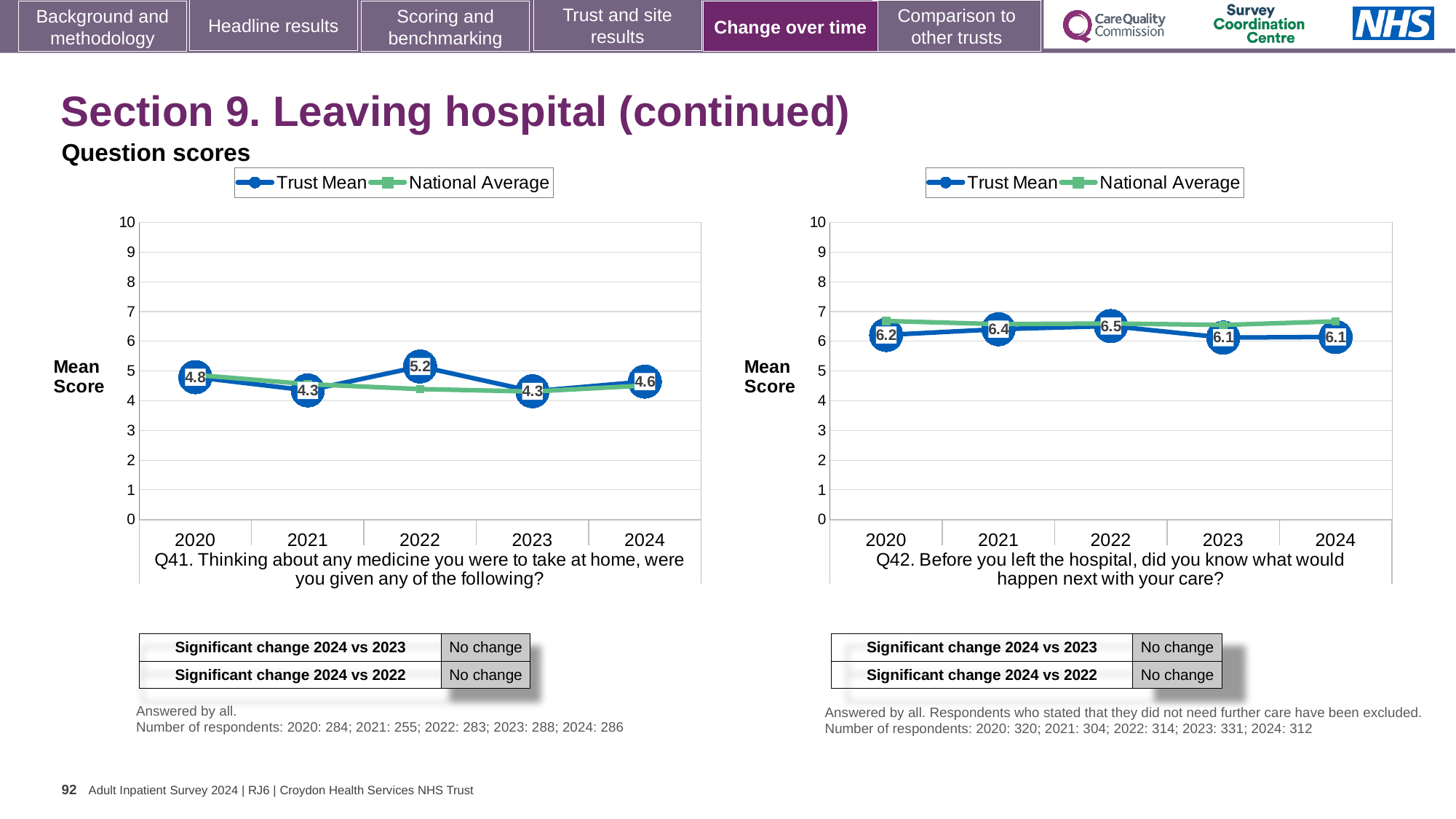
How many years are plotted on the Q42 chart? 5 On the Q41 chart, which year has the highest Trust Mean score? 2022 What type of chart is used for Q41? Line chart On the Q42 chart, which year has the highest Trust Mean score? 2022 On the Q42 chart, what is the Trust Mean score for 2021? 6.4 On the Q42 chart, what is the difference between the Trust Mean scores for 2022 and 2024? 0.4 On the Q41 chart, is the Trust Mean score for 2020 greater or less than the score for 2021? greater How many series does the legend of the Q41 chart list? 2 On the Q41 chart, what is the difference between the Trust Mean scores for 2022 and 2023? 0.9 On the Q41 chart, what is the Trust Mean score for 2024? 4.6 On the Q41 chart, what is the Trust Mean score for 2022? 5.2 On the Q42 chart, is the National Average for 2020 greater or less than 6? greater